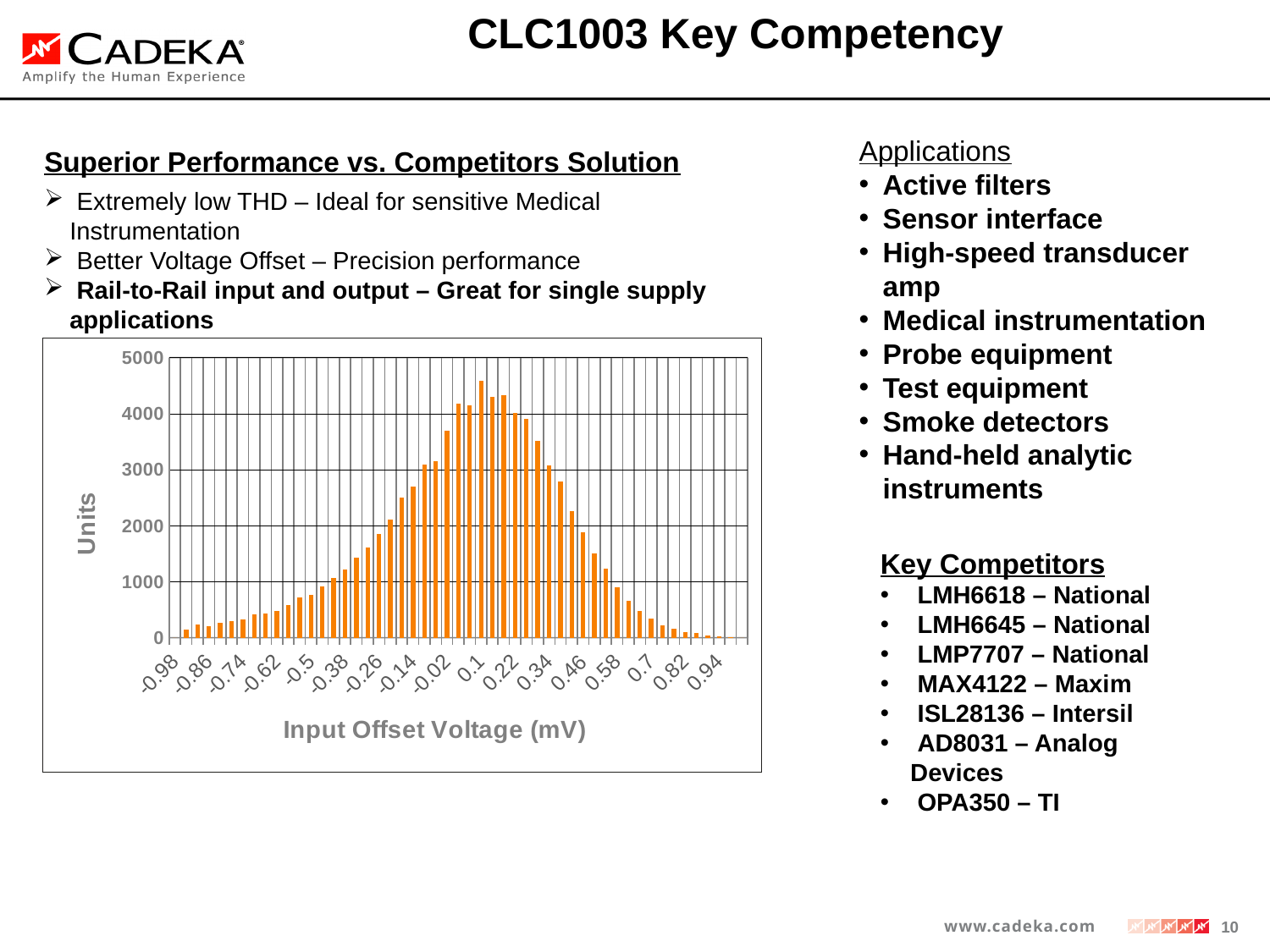
Is the value for 0.1 mV greater or less than 4000? greater Which has more units, 0.1 mV or -0.98 mV? 0.1 mV Around which input offset voltage do the units reach their highest value? 0.1 mV What is the label of the horizontal axis of the chart? Input Offset Voltage (mV) Is the value for 0.94 mV greater or less than 1000? less Is the value for 0.7 mV greater or less than 1000? less What is the label of the vertical axis of the chart? Units What kind of chart is shown on the slide? bar chart